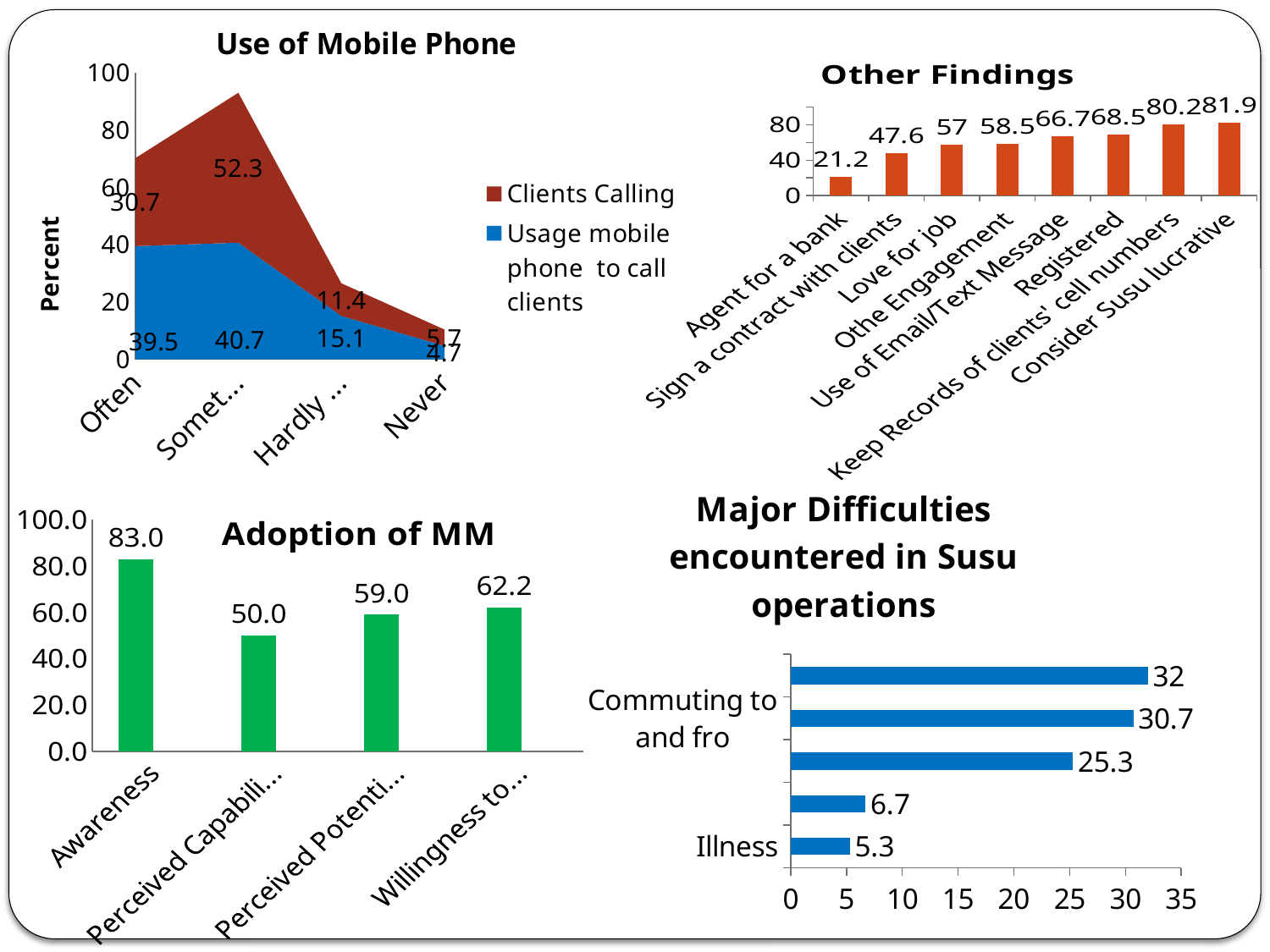
In the 'Other Findings' chart, what is the value for 'Agent for a bank'? 21.2 In the 'Adoption of MM' chart, what type of chart is used? Bar chart In the 'Other Findings' chart, which category has the highest value? Consider Susu lucrative In the 'Other Findings' chart, how many categories are shown? 8 In the 'Major Difficulties encountered in Susu operations' chart, how many bars are shown? 5 In the 'Major Difficulties encountered in Susu operations' chart, what is the value for 'Illness'? 5.3 In the 'Adoption of MM' chart, what is the value for 'Awareness'? 83.0 In the 'Adoption of MM' chart, what is the difference between the 'Awareness' value and the 'Perceived Capabili...' value? 33.0 In the 'Use of Mobile Phone' chart, what is the 'Clients Calling' value for 'Often'? 30.7 In the 'Other Findings' chart, which category has the lowest value? Agent for a bank In the 'Use of Mobile Phone' chart, how many series does the legend list? 2 In the 'Use of Mobile Phone' chart, which is larger for 'Never': the 'Clients Calling' value or the 'Usage mobile phone to call clients' value? Clients Calling